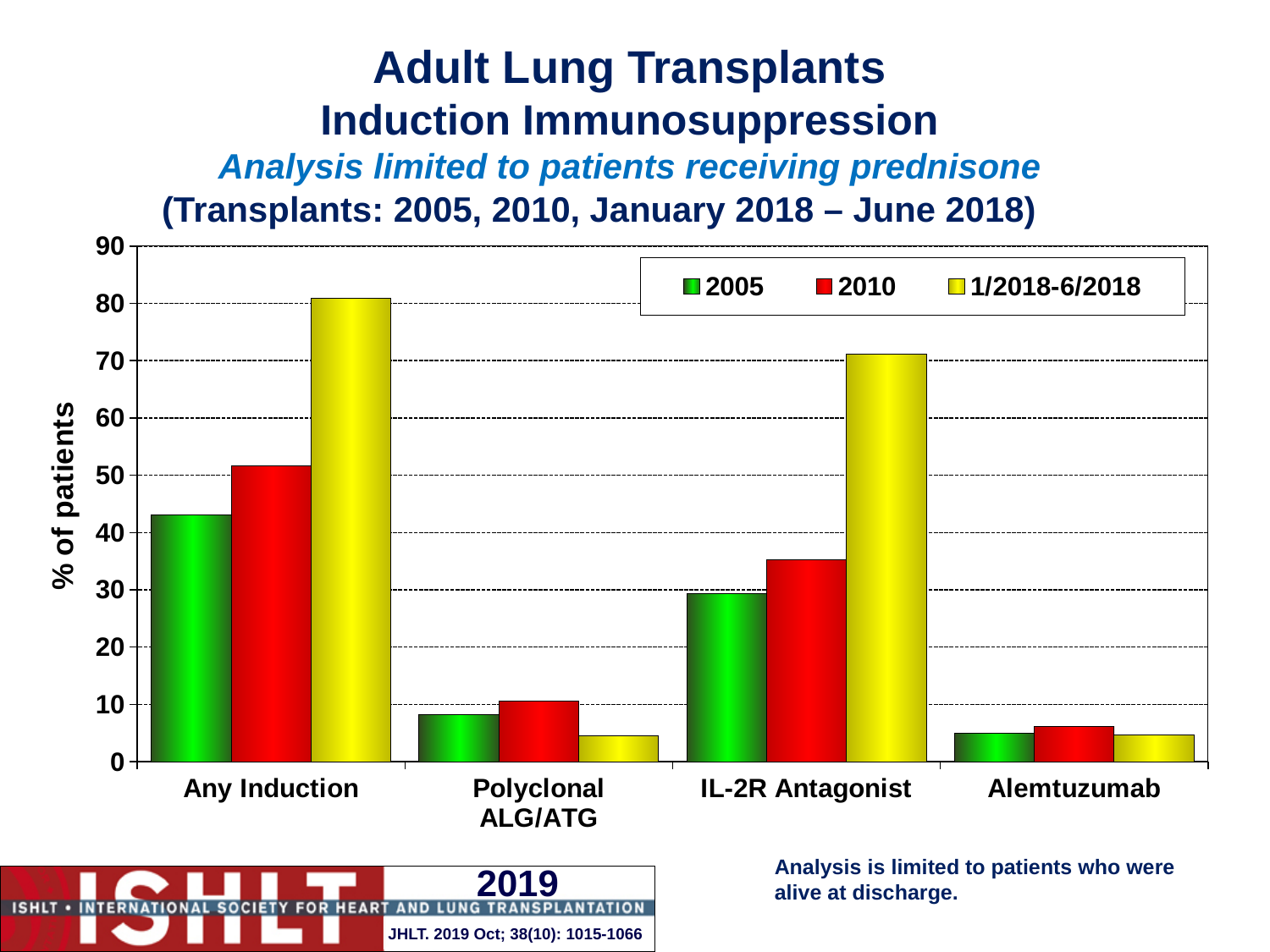
Which category has the highest value for the 1/2018-6/2018 series? Any Induction Which category has the lowest value for the 2005 series? Alemtuzumab What is the label on the y axis? % of patients Is the 2010 value for Polyclonal ALG/ATG greater or less than 20? less Is the 2005 value for Any Induction greater or less than 40? greater How many series does the legend list? 3 How many induction categories are shown on the x axis? 4 For Any Induction, which is larger: the 2005 value or the 2010 value? 2010 Which category has the lowest value for the 2010 series? Alemtuzumab Is the 1/2018-6/2018 value for IL-2R Antagonist greater or less than 60? greater What kind of chart is shown on the slide? Bar chart